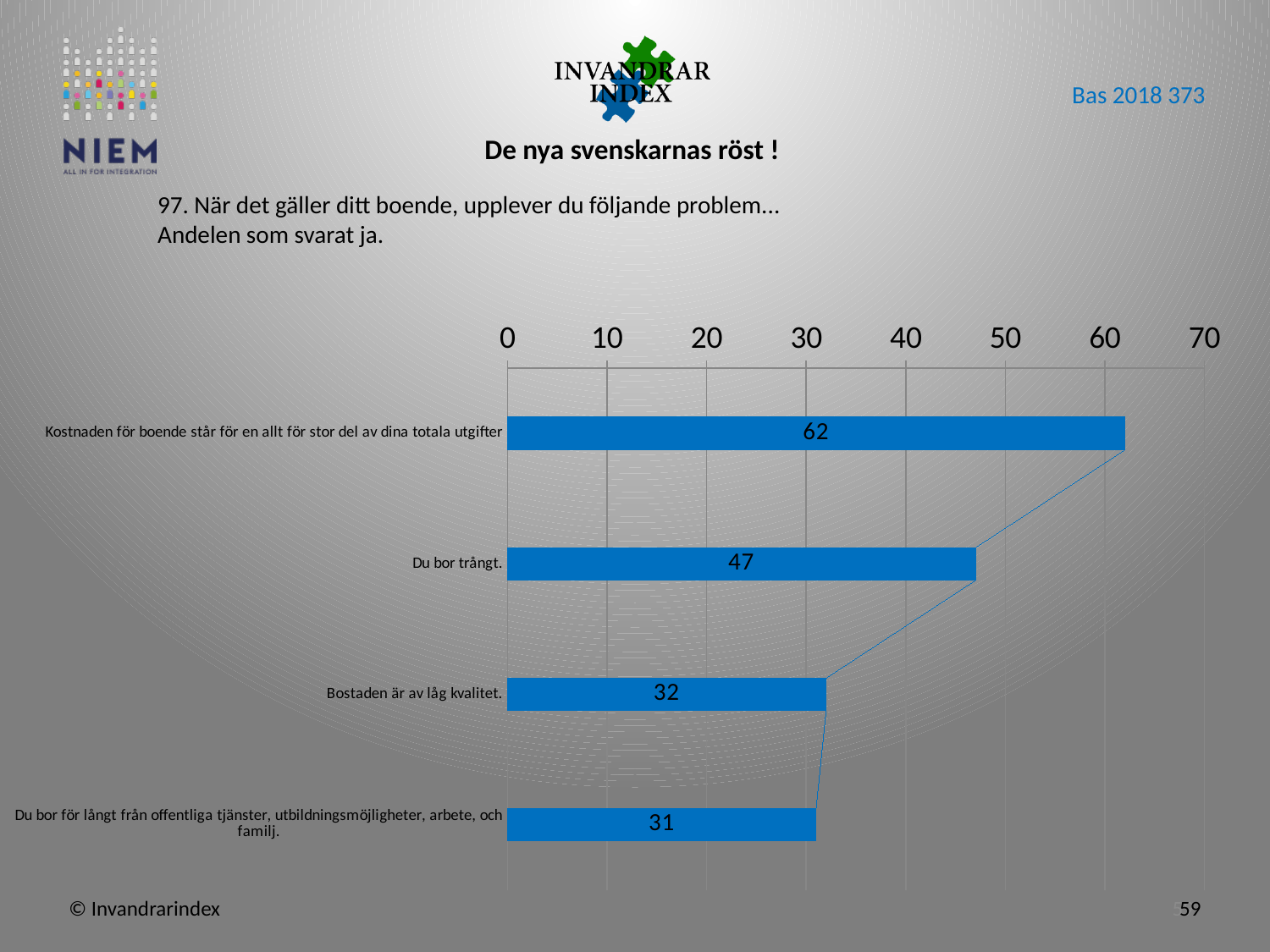
What is the value for "Kostnaden för boende står för en allt för stor del av dina totala utgifter"? 62 What is the value for "Du bor trångt."? 47 Which category has the highest value? Kostnaden för boende står för en allt för stor del av dina totala utgifter What kind of chart is shown on the slide? bar chart What is the highest value shown on the chart's axis? 70 Which is larger: the value for "Du bor trångt." or the value for "Bostaden är av låg kvalitet."? Du bor trångt. What is the value for "Du bor för långt från offentliga tjänster, utbildningsmöjligheter, arbete, och familj."? 31 Which category has the lowest value? Du bor för långt från offentliga tjänster, utbildningsmöjligheter, arbete, och familj. How many categories are shown in the chart? 4 What is the difference between the values for "Kostnaden för boende står för en allt för stor del av dina totala utgifter" and "Du bor trångt."? 15 What is the difference between the values for "Du bor trångt." and "Bostaden är av låg kvalitet."? 15 What is the value for "Bostaden är av låg kvalitet."? 32